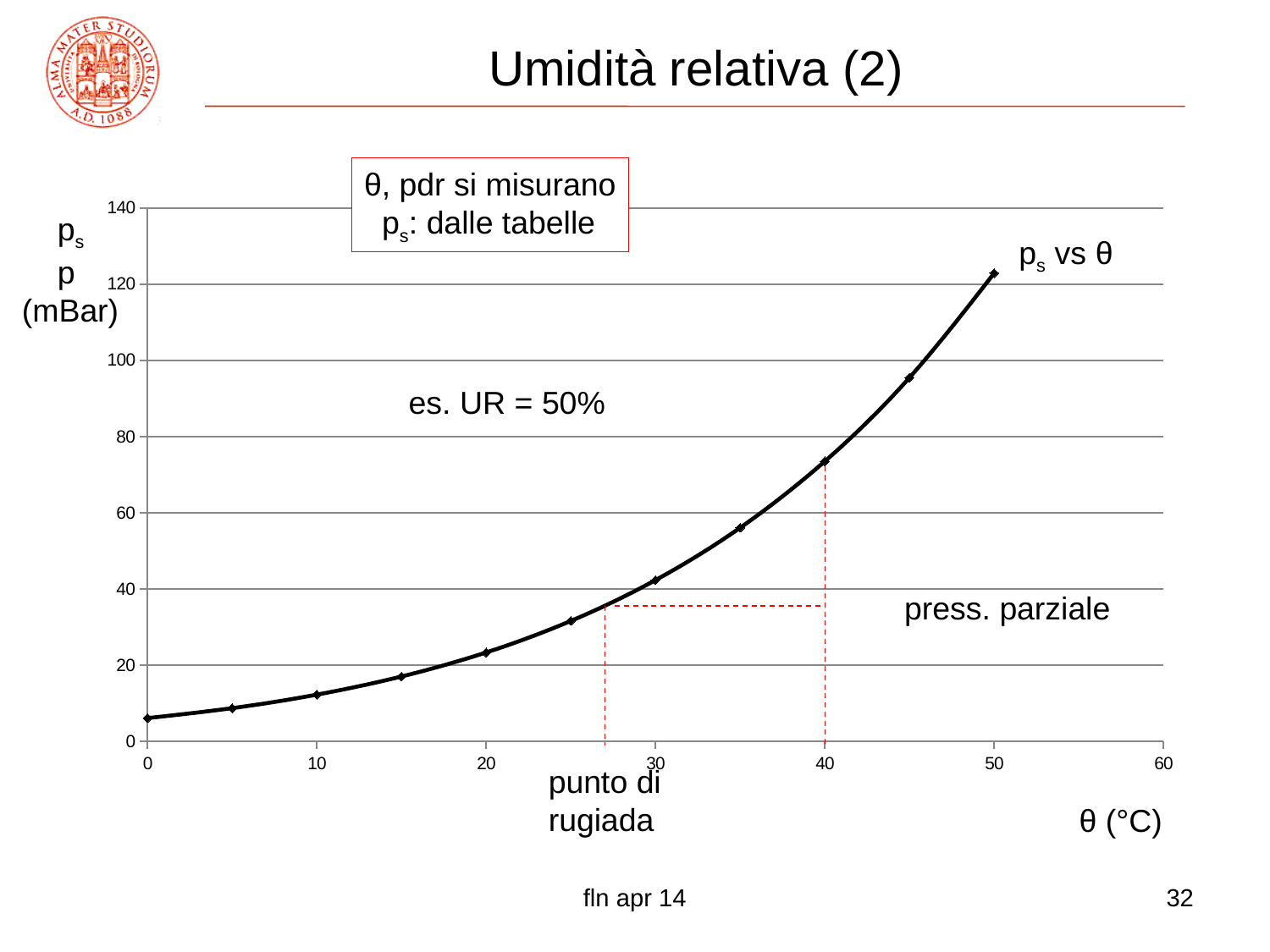
How many data points are marked on the curve? 11 Is the value at θ = 10 greater or less than 20? less What unit is shown on the x axis of the chart? °C Is the value at θ = 50 greater or less than 120? greater At which value of θ is the plotted pressure lowest? 0 What kind of chart is shown on the slide? line chart Is the value at θ = 40 greater or less than 60? greater Which is larger, the value at θ = 30 or the value at θ = 20? θ = 30 Do the values of the curve rise or fall as θ increases along the x axis? rise At which value of θ is the plotted pressure highest? 50